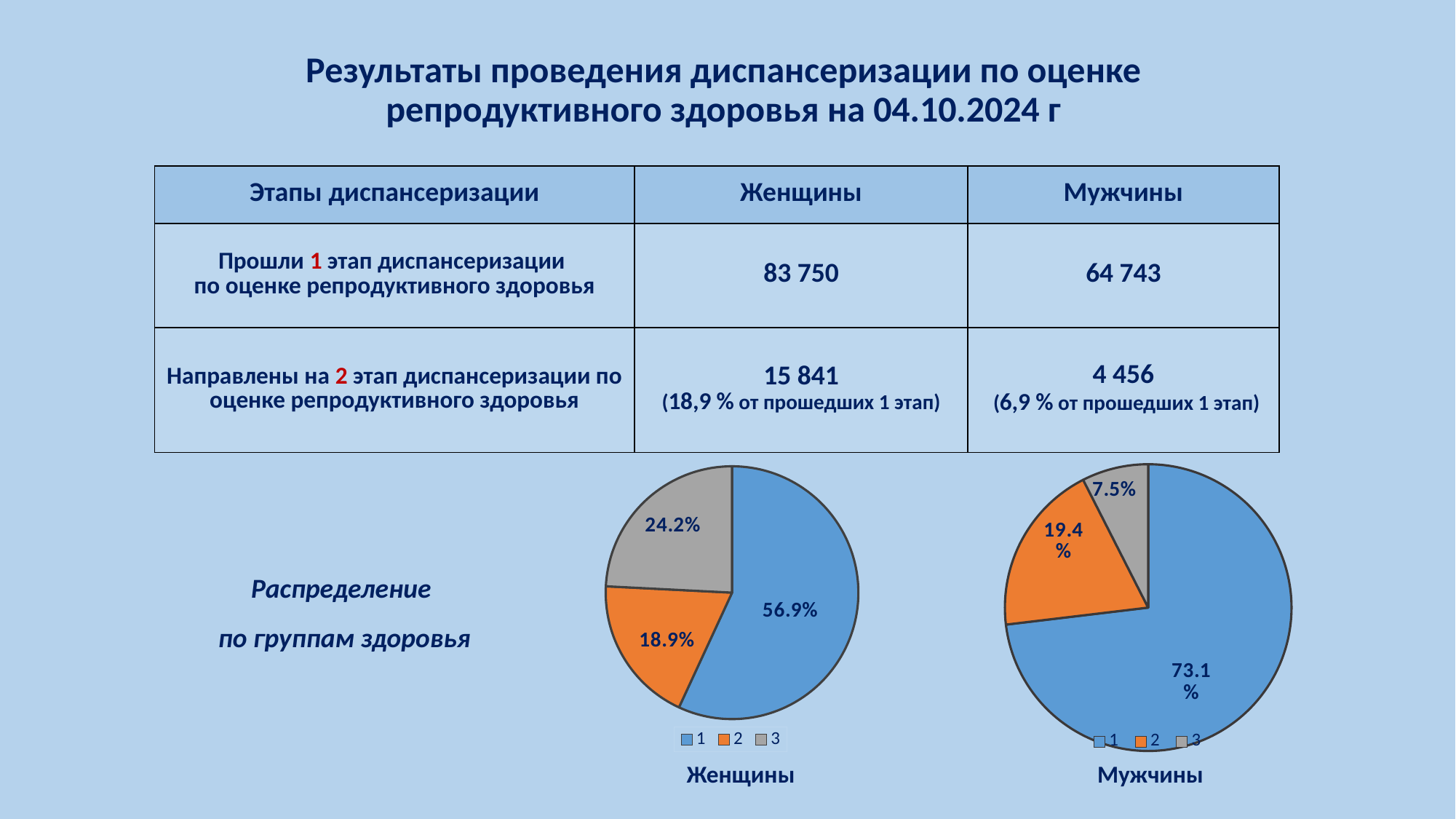
In the Женщины pie chart, what colour is the slice for group 2? orange In the Женщины pie chart, what is the difference between the shares of group 3 and group 2? 5.3% In the Женщины pie chart, what share does health group 3 have? 24.2% In the Женщины pie chart, which health group has the smallest share? 2 In the Мужчины pie chart, which is larger: the share of group 2 or the share of group 3? group 2 In the Мужчины pie chart, which health group has the smallest share? 3 How many categories does the legend of the Мужчины pie chart list? 3 In the Мужчины pie chart, what share does health group 3 have? 7.5% In the Женщины pie chart, what share does health group 1 have? 56.9% In the Женщины pie chart, which health group has the largest share? 1 In the Мужчины pie chart, what share does health group 1 have? 73.1% What type of chart is used for the Женщины distribution? pie chart